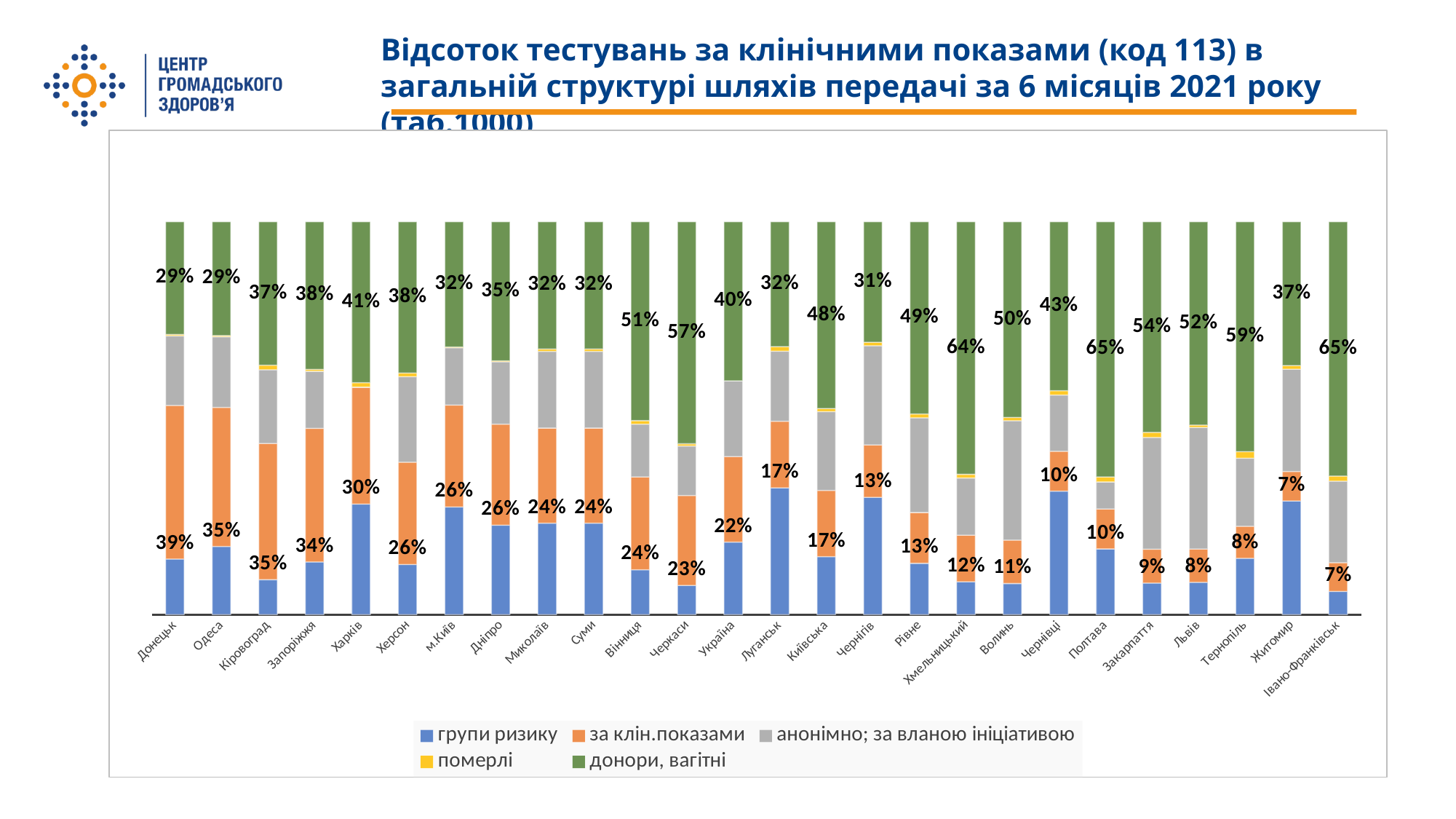
Which region has the highest labelled share of 'за клін.показами'? Донецьк What kind of chart is shown on the slide? stacked bar chart What is the labelled share of 'донори, вагітні' for Хмельницький? 64% What is the labelled share of 'за клін.показами' for Україна? 22% Which is larger, the 'за клін.показами' share for Харків or for Херсон? Харків Which is larger, the 'донори, вагітні' share for Полтава or for Чернівці? Полтава What is the difference between the 'за клін.показами' share for Донецьк (39%) and for Україна (22%)? 17 percentage points What is the labelled share of 'донори, вагітні' for Черкаси? 57% How many series does the legend list? 5 How many regions (bars) are shown on the x axis? 26 What is the labelled share of 'за клін.показами' for Донецьк? 39% Which colour represents 'донори, вагітні' in the legend? green